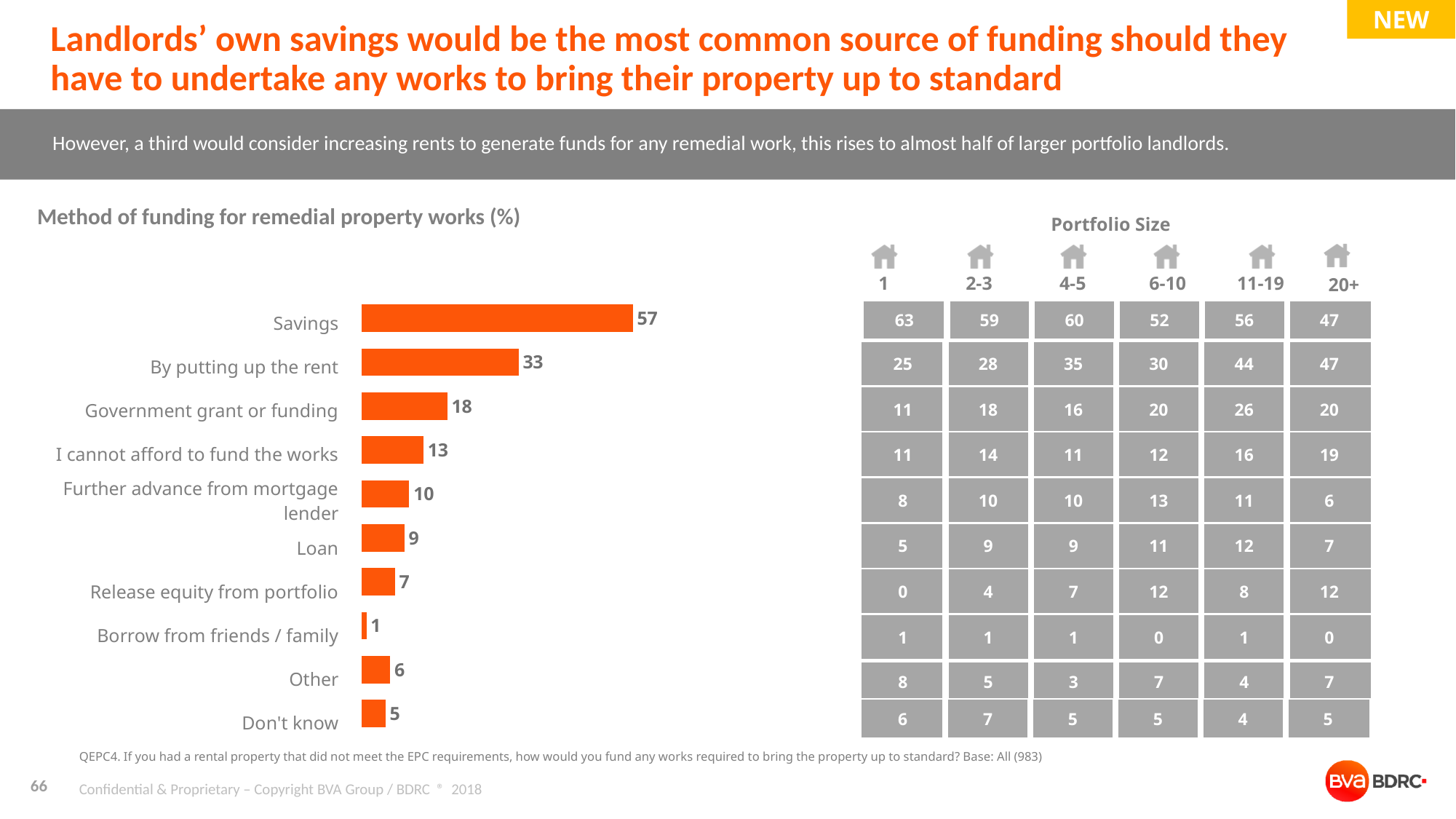
How many categories are shown in the bar chart? 10 What is the value for 'By putting up the rent' in the bar chart? 33 Which category has the lowest value in the bar chart? Borrow from friends / family What is the value for Savings in the 'Method of funding for remedial property works (%)' chart? 57 What kind of chart is used to show the method of funding for remedial property works? Bar chart What is the value for 'Government grant or funding' in the bar chart? 18 Which is larger in the bar chart: 'I cannot afford to fund the works' or Loan? I cannot afford to fund the works Which category has the highest value in the bar chart? Savings What is the difference between the values for Other and Don't know in the bar chart? 1 What is the title of the bar chart on the slide? Method of funding for remedial property works (%) What is the value for 'Release equity from portfolio' in the bar chart? 7 What is the difference between the values for Savings and 'By putting up the rent' in the bar chart? 24